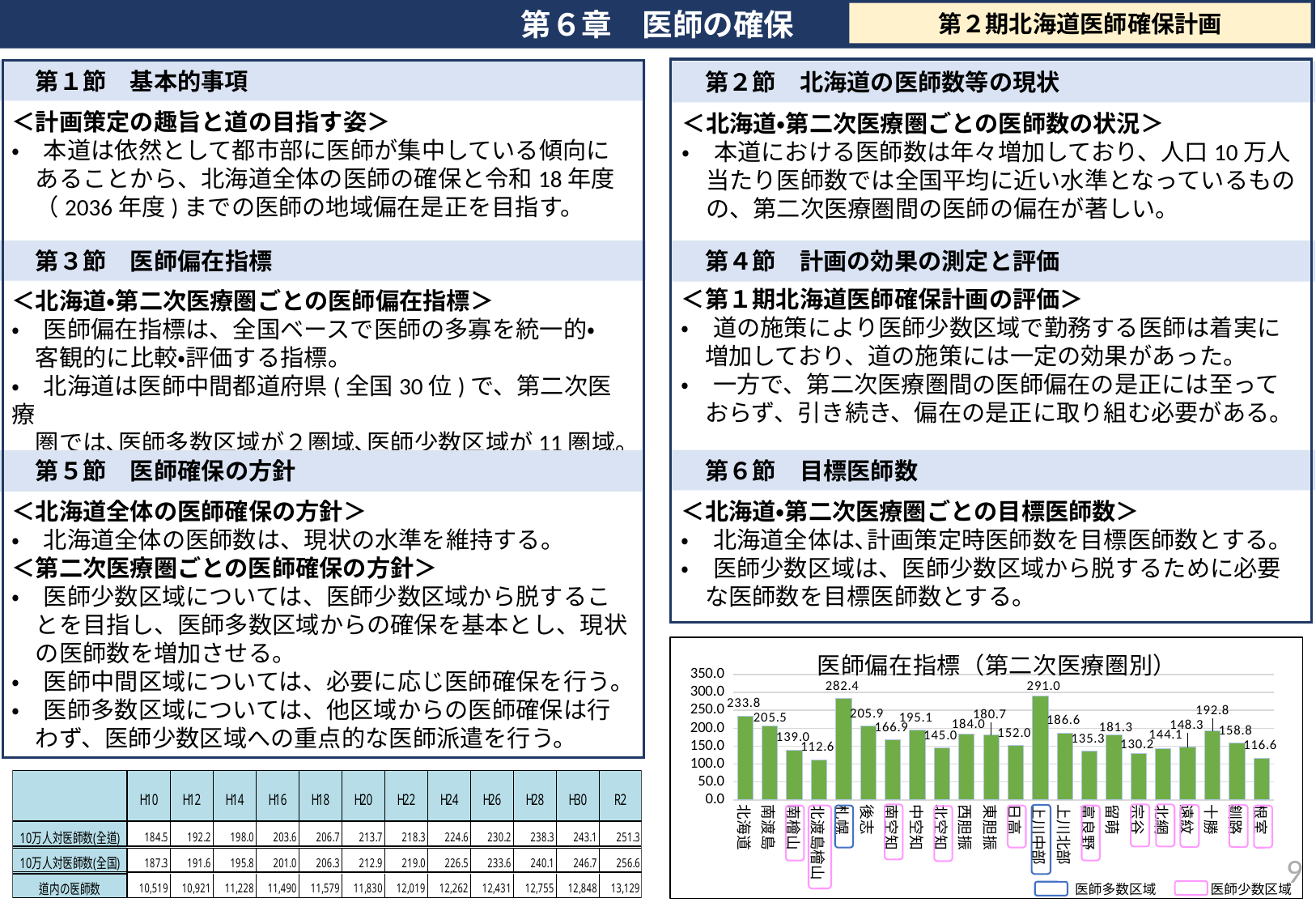
In the chart 医師偏在指標（第二次医療圏別）, which region has the lowest value? 北渡島檜山 How many regions (bars) are shown in the chart 医師偏在指標（第二次医療圏別）? 22 In the chart 医師偏在指標（第二次医療圏別）, what is the difference between the values for 上川中部 and 札幌? 8.6 In the chart 医師偏在指標（第二次医療圏別）, what is the difference between the values for 北海道 and 根室? 117.2 What type of chart is 医師偏在指標（第二次医療圏別）? bar chart In the chart 医師偏在指標（第二次医療圏別）, what does the blue box in the legend indicate? 医師多数区域 In the chart 医師偏在指標（第二次医療圏別）, what is the value for 十勝? 192.8 In the chart 医師偏在指標（第二次医療圏別）, which is larger, the value for 南渡島 or the value for 後志? 後志 In the chart 医師偏在指標（第二次医療圏別）, which region has the highest value? 上川中部 In the chart 医師偏在指標（第二次医療圏別）, what is the value for 北海道? 233.8 In the chart 医師偏在指標（第二次医療圏別）, is the value for 宗谷 greater or less than 150.0? less In the chart 医師偏在指標（第二次医療圏別）, what is the value for 札幌? 282.4